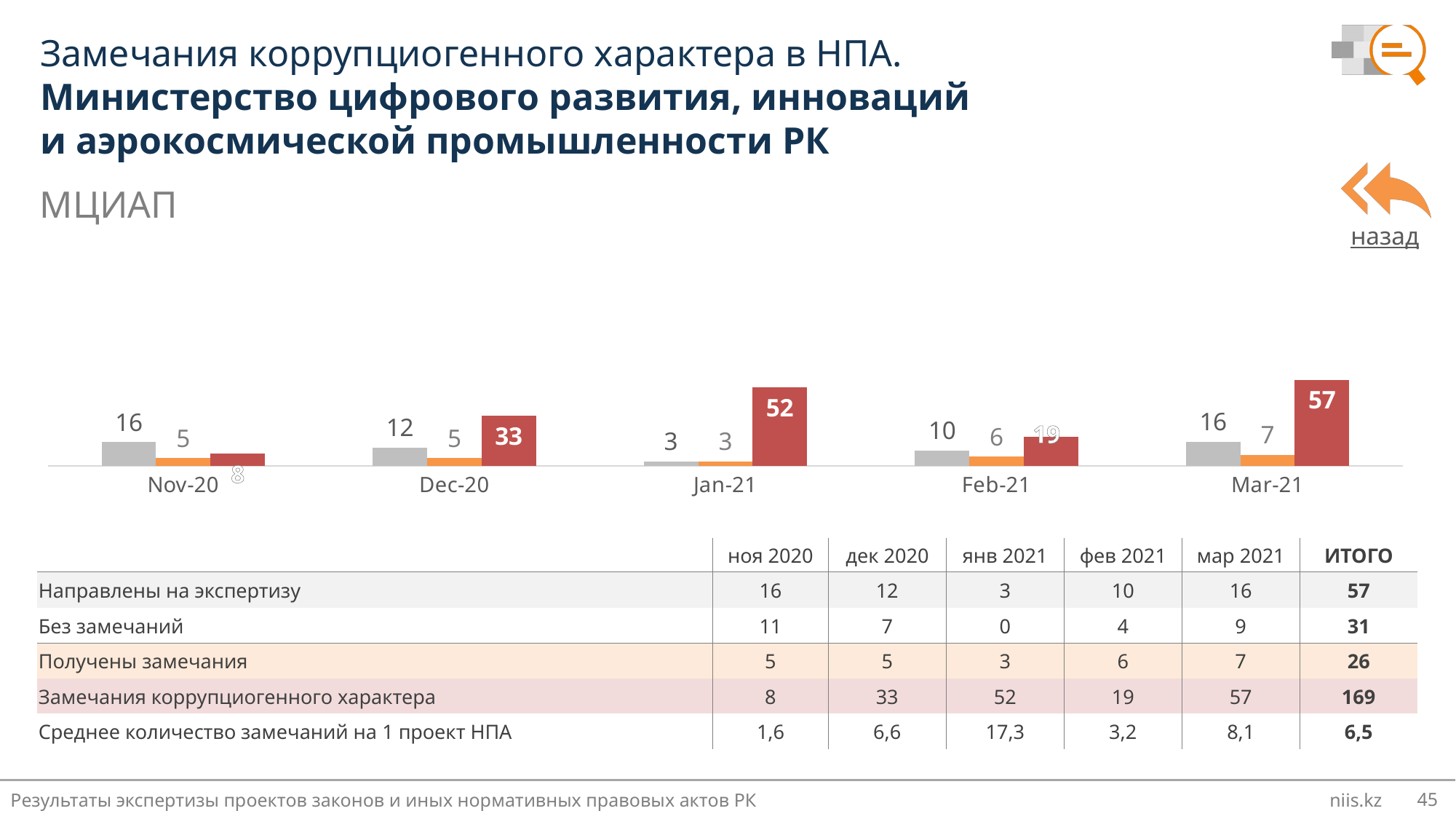
In which month is the red bar the highest? Mar-21 What is the value of the red bar for Jan-21? 52 What is the value of the grey bar for Dec-20? 12 How many bars are shown for each month in the chart? 3 What type of chart is shown on the slide? bar chart Does the grey bar value rise or fall from Nov-20 to Jan-21? fall Which is larger: the red bar for Dec-20 or the red bar for Jan-21? Jan-21 What is the difference between the red bar values for Mar-21 and Feb-21? 38 What is the value of the orange bar for Feb-21? 6 What is the value of the red bar for Nov-20? 8 In which month is the grey bar the lowest? Jan-21 How many months (categories) are shown on the x axis of the chart? 5